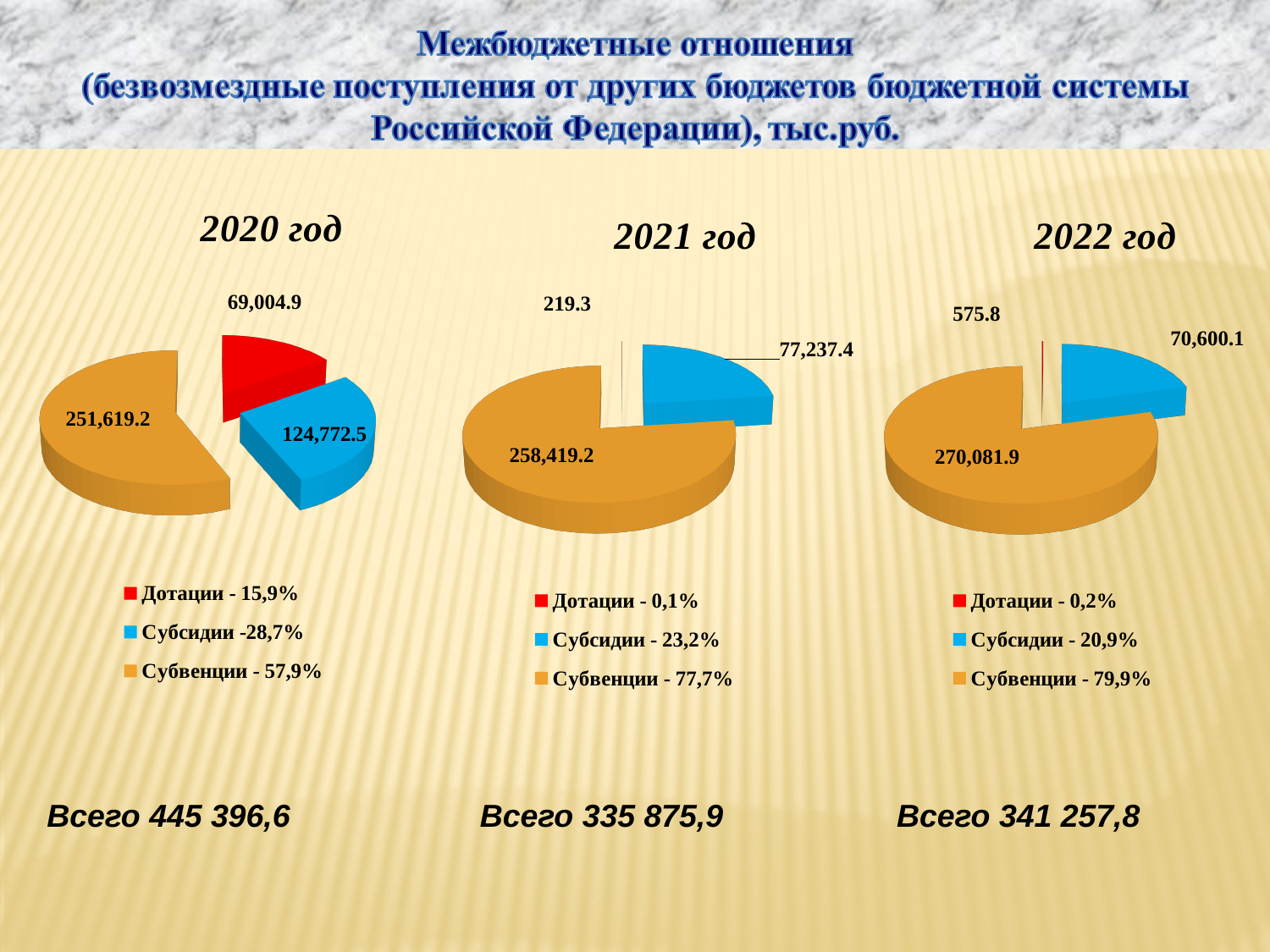
How many slices does the 2020 год pie chart have? 3 In the 2020 год pie chart, what is the difference between Субвенции and Субсидии? 126,846.7 What share of the 2021 год pie does Субсидии represent, according to the legend? 23,2% In the 2021 год pie chart, which category has the smallest slice? Дотации In the 2020 год pie chart, which category has the largest slice? Субвенции What colour represents Субвенции in the legends of the three pie charts? Orange In the 2022 год pie chart, what is the value for Дотации? 575.8 What share of the 2022 год pie does Субвенции represent, according to the legend? 79,9% What kind of chart is used for the 2021 год data? Pie chart In the 2022 год pie chart, which is larger, Субсидии or Дотации? Субсидии In the 2020 год pie chart, what is the value for Субвенции? 251,619.2 In the 2021 год pie chart, what is the value for Субсидии? 77,237.4